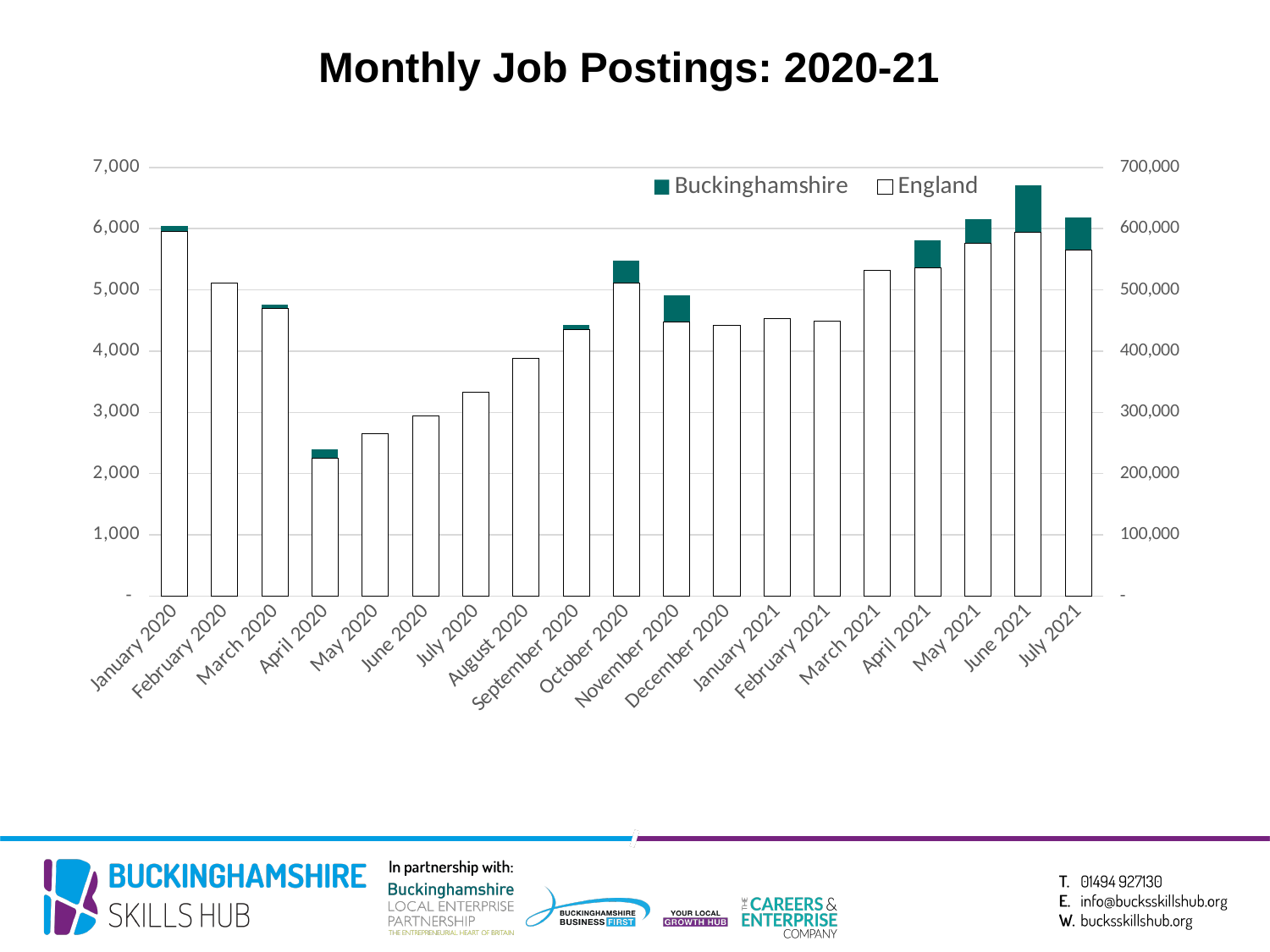
Is the Buckinghamshire value for April 2020 greater or less than 3,000? less How many series does the legend list? 2 What kind of chart is shown on the slide? bar chart Which month has the tallest bar? June 2021 Is the Buckinghamshire value for June 2021 greater or less than 6,000? greater Is the England value for May 2020 greater or less than 300,000? less Which is larger, the bar for June 2021 or the bar for April 2020? June 2021 Which month has the shortest bar? April 2020 How many months are shown along the x axis? 19 Which two series are listed in the legend? Buckinghamshire and England What is the title of the chart? Monthly Job Postings: 2020-21 Do the values rise or fall from April 2020 to October 2020? rise